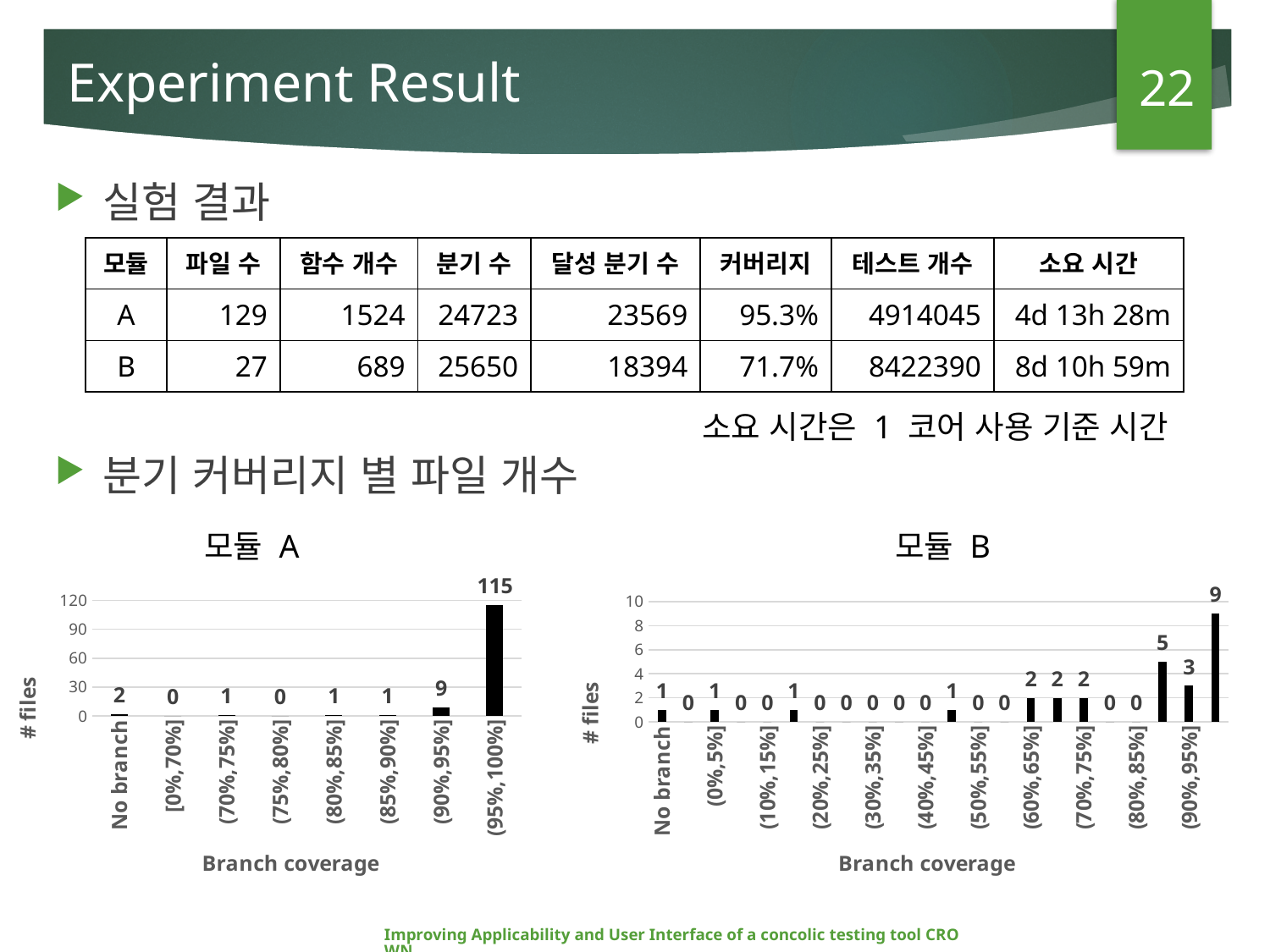
In the 모듈 A chart, how many files fall in the (90%,95%] bin? 9 In the 모듈 A chart, how many files fall in the (95%,100%] branch coverage bin? 115 In the 모듈 A chart, which branch coverage bin has the most files? (95%,100%] What is the y-axis title of the 모듈 B chart? # files In the 모듈 A chart, which is larger: the value for (90%,95%] or the value for No branch? (90%,95%] In the 모듈 A chart, is the value for (95%,100%] greater or less than 90? greater In the 모듈 A chart, what is the value for No branch? 2 In the 모듈 A chart, what is the difference between the (95%,100%] bin and the (90%,95%] bin? 106 In the 모듈 B chart, what is the highest value shown on any bar? 9 What kind of chart is the 모듈 A chart? bar chart In the 모듈 B chart, how many files fall in the (90%,95%] bin? 3 How many branch coverage categories are shown on the x axis of the 모듈 A chart? 8